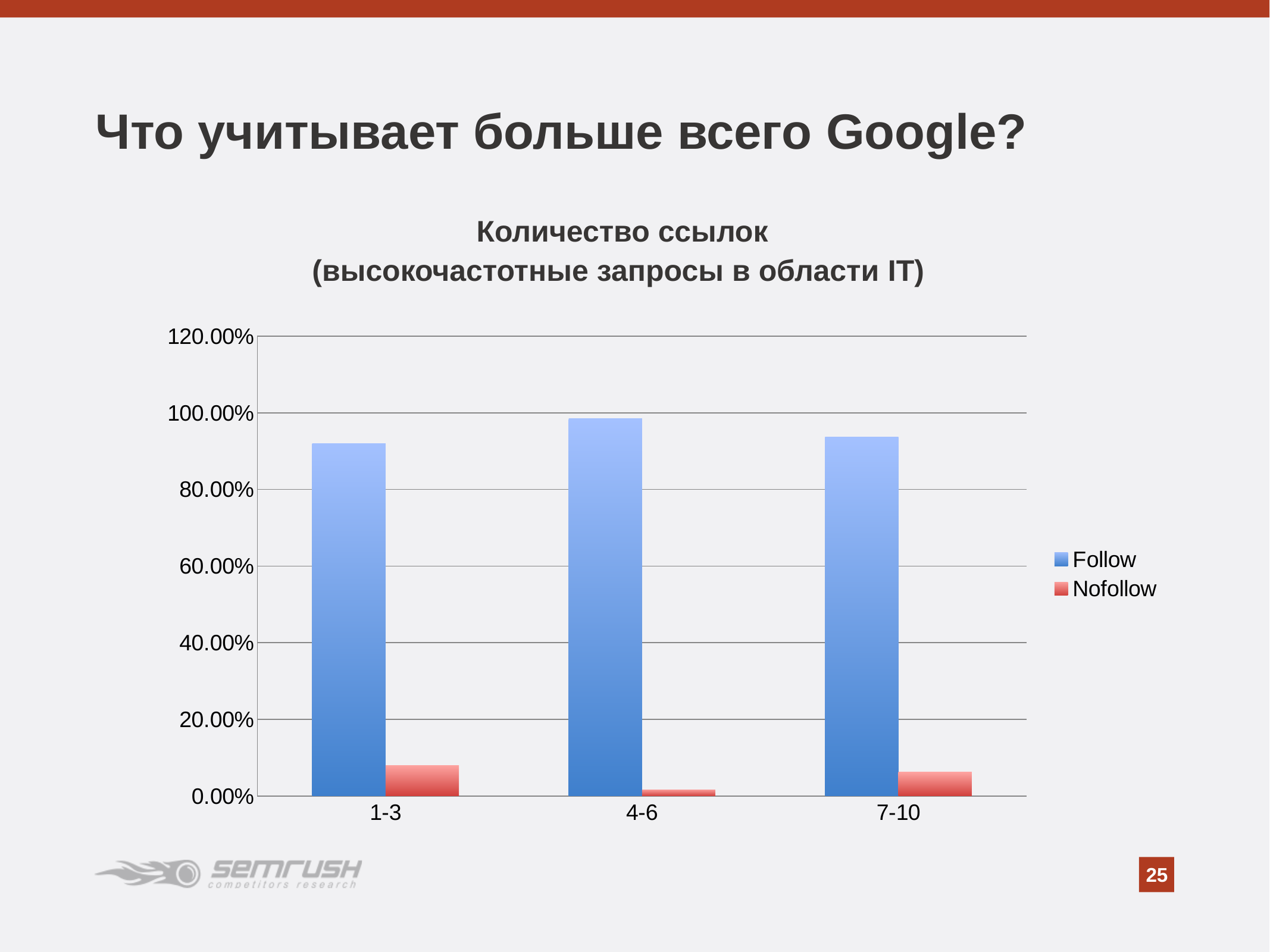
What kind of chart is shown on the slide? bar chart Is the Nofollow value for 1-3 greater or less than 20.00%? less How many series does the legend list? 2 For which category is the Follow value highest? 4-6 What is the title of the chart? Количество ссылок (высокочастотные запросы в области IT) Is the Follow value for 1-3 greater or less than 80.00%? greater Which series are listed in the legend? Follow, Nofollow For which category is the Nofollow value lowest? 4-6 For the 4-6 category, which is larger: Follow or Nofollow? Follow Is the Follow value for 7-10 greater or less than 80.00%? greater How many categories are shown on the x axis? 3